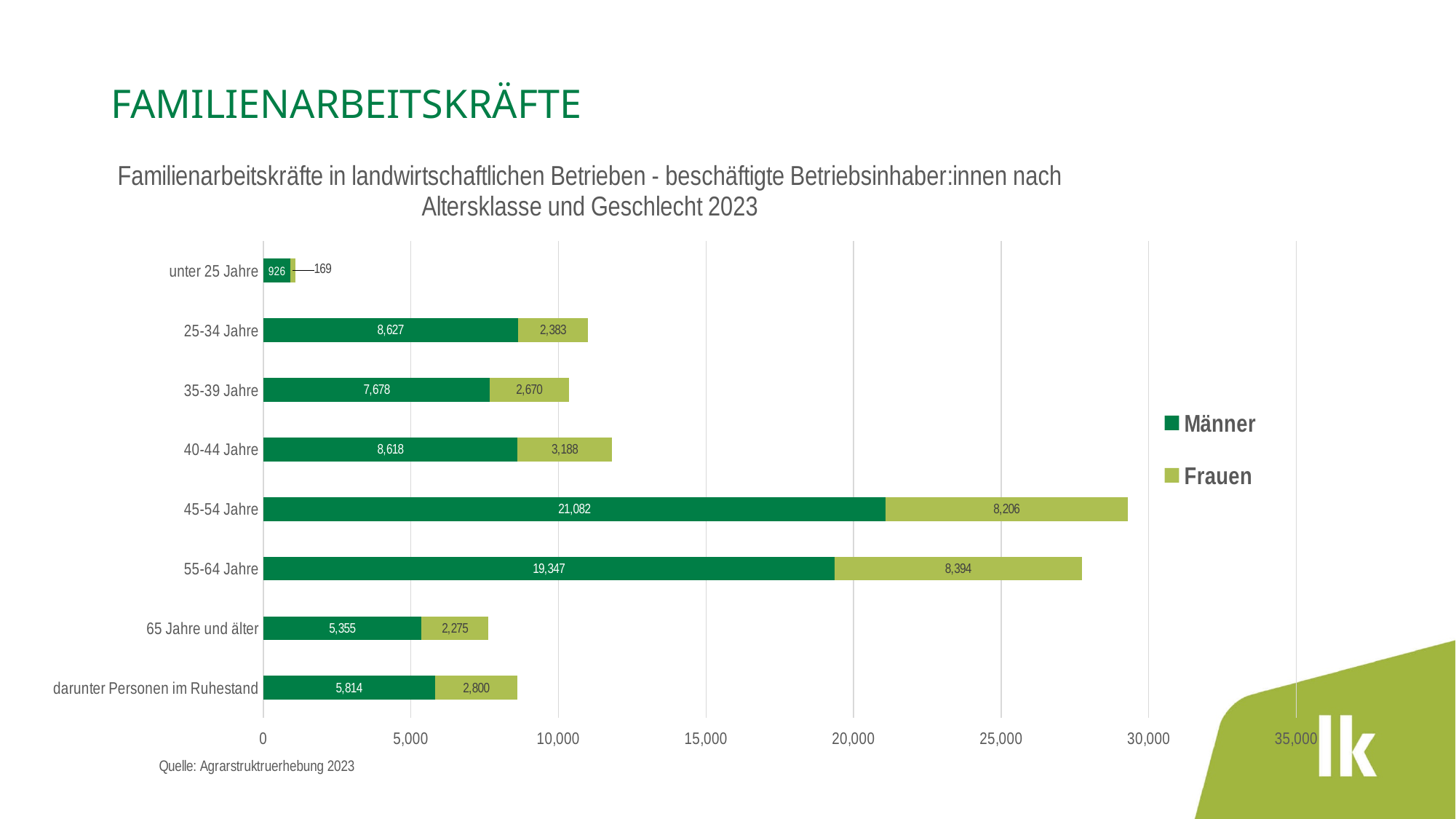
What kind of chart is shown on the slide? Stacked bar chart What is the value for Frauen in the unter 25 Jahre category? 169 Which category has the highest value for Männer? 45-54 Jahre Which category has the lowest value for Frauen? unter 25 Jahre How many series does the legend list? 2 What is the total of the stacked bar for 25-34 Jahre? 11,010 How many age categories are plotted on the chart? 8 Which is larger: the Frauen value for 55-64 Jahre or for 45-54 Jahre? 55-64 Jahre Which series is shown in dark green in the legend? Männer What is the value for Frauen in the 35-39 Jahre category? 2,670 What is the difference between the Männer values for 45-54 Jahre and 55-64 Jahre? 1,735 What is the value for Männer in the 45-54 Jahre category? 21,082